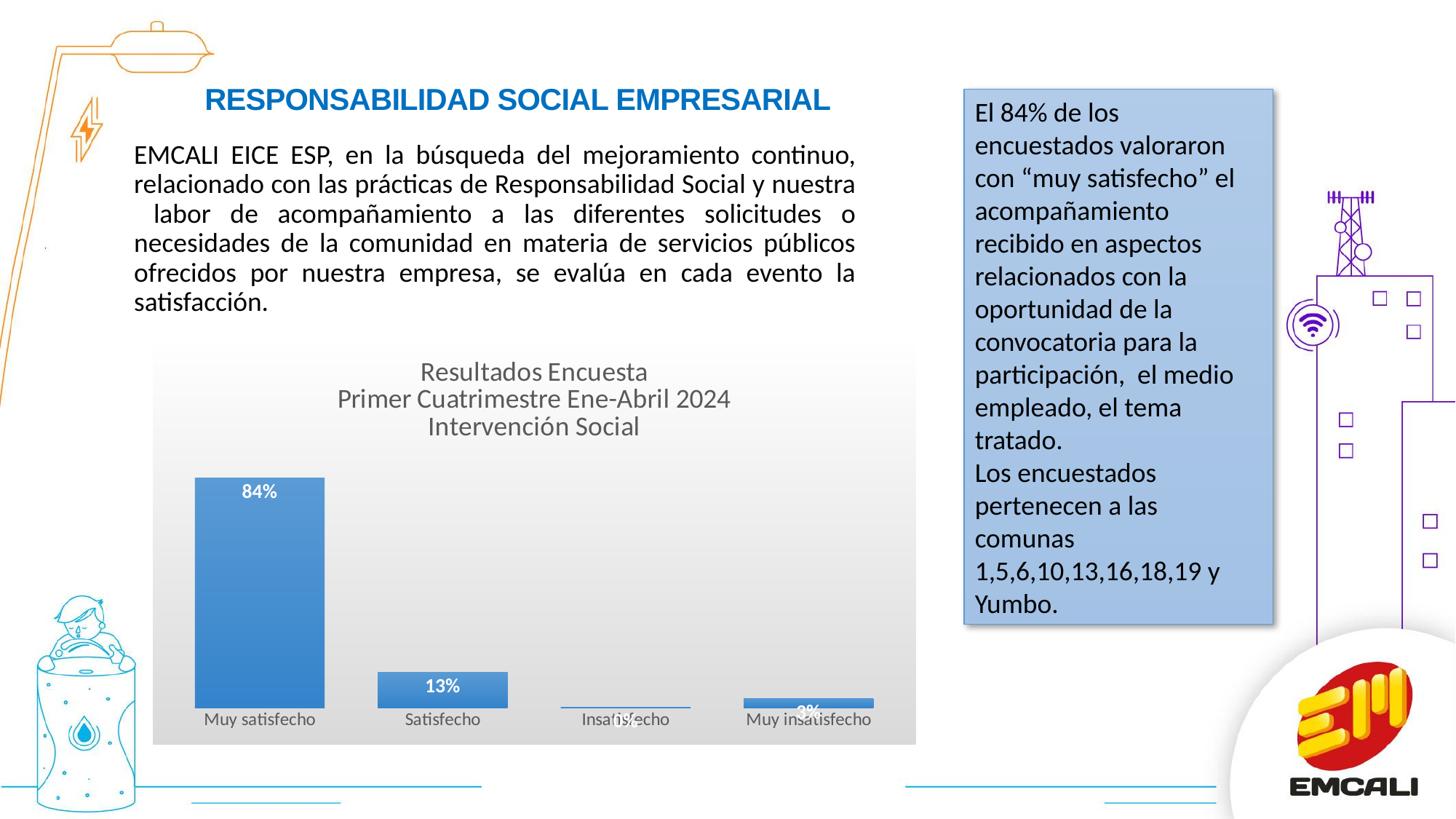
What kind of chart is shown on the slide? Bar chart Which category has the lowest value in the chart? Insatisfecho What is the title of the chart? Resultados Encuesta Primer Cuatrimestre Ene-Abril 2024 Intervención Social What is the difference between the values for Muy satisfecho and Satisfecho? 71% How many categories are shown in the chart? 4 What is the value for Satisfecho in the chart? 13% What is the value for Muy satisfecho in the chart? 84% Which is larger, the value for Satisfecho or the value for Muy insatisfecho? Satisfecho What is the value for Muy insatisfecho in the chart? 3% Which category has the highest value in the chart? Muy satisfecho What is the difference between the values for Satisfecho and Muy insatisfecho? 10%